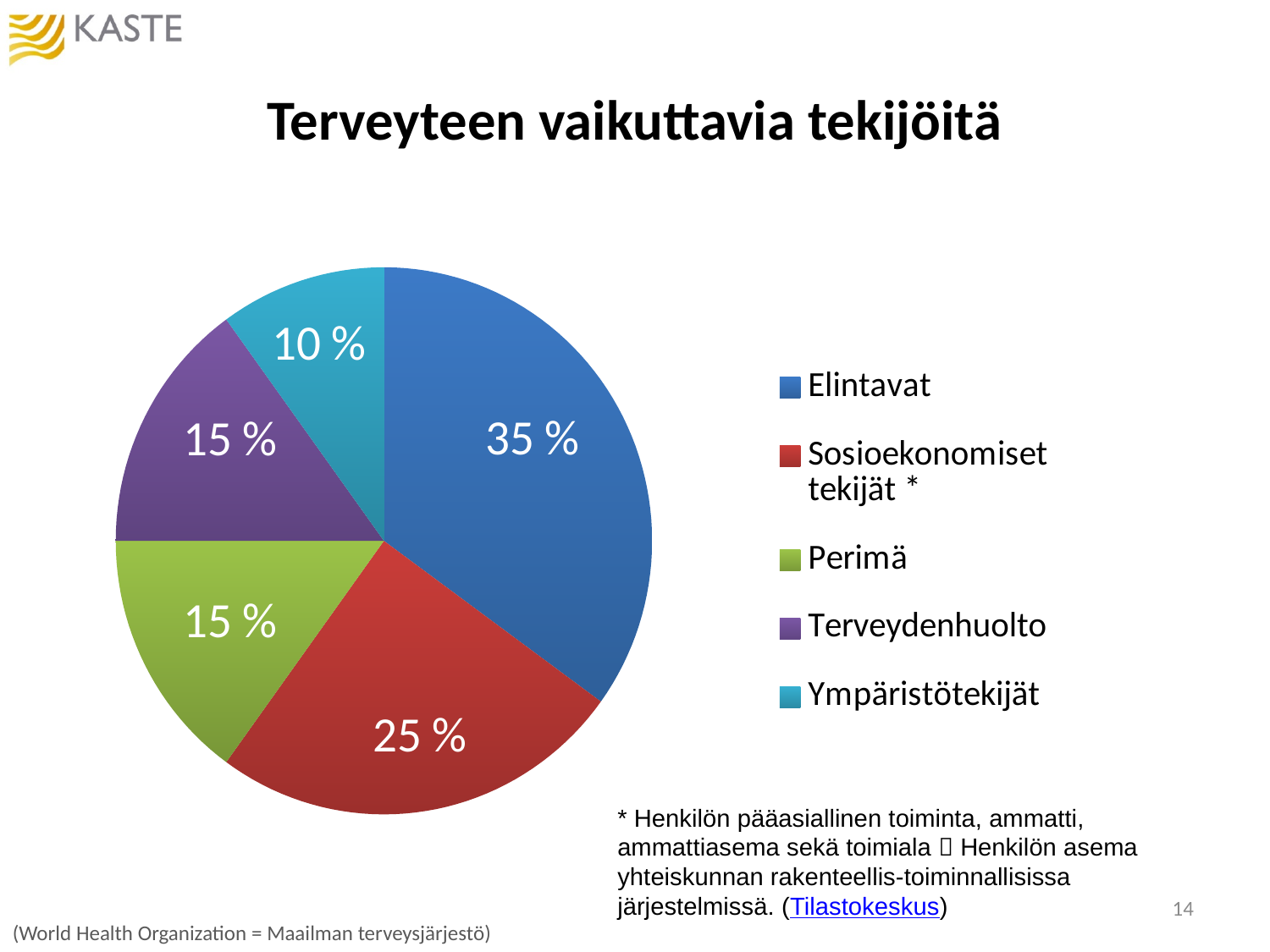
Which legend entry is marked with an asterisk? Sosioekonomiset tekijät What kind of chart is shown on the slide? pie chart What share of the pie does Perimä have? 15 % What share of the pie does Elintavat have? 35 % What share of the pie does Ympäristötekijät have? 10 % Which is larger, the share of Terveydenhuolto or the share of Ympäristötekijät? Terveydenhuolto How many slices does the pie chart have? 5 What is the difference between the shares of Elintavat and Sosioekonomiset tekijät? 10 % What is the title of the slide containing the pie chart? Terveyteen vaikuttavia tekijöitä What share of the pie does Sosioekonomiset tekijät have? 25 % Which category has the smallest slice of the pie? Ympäristötekijät Which category has the largest slice of the pie? Elintavat